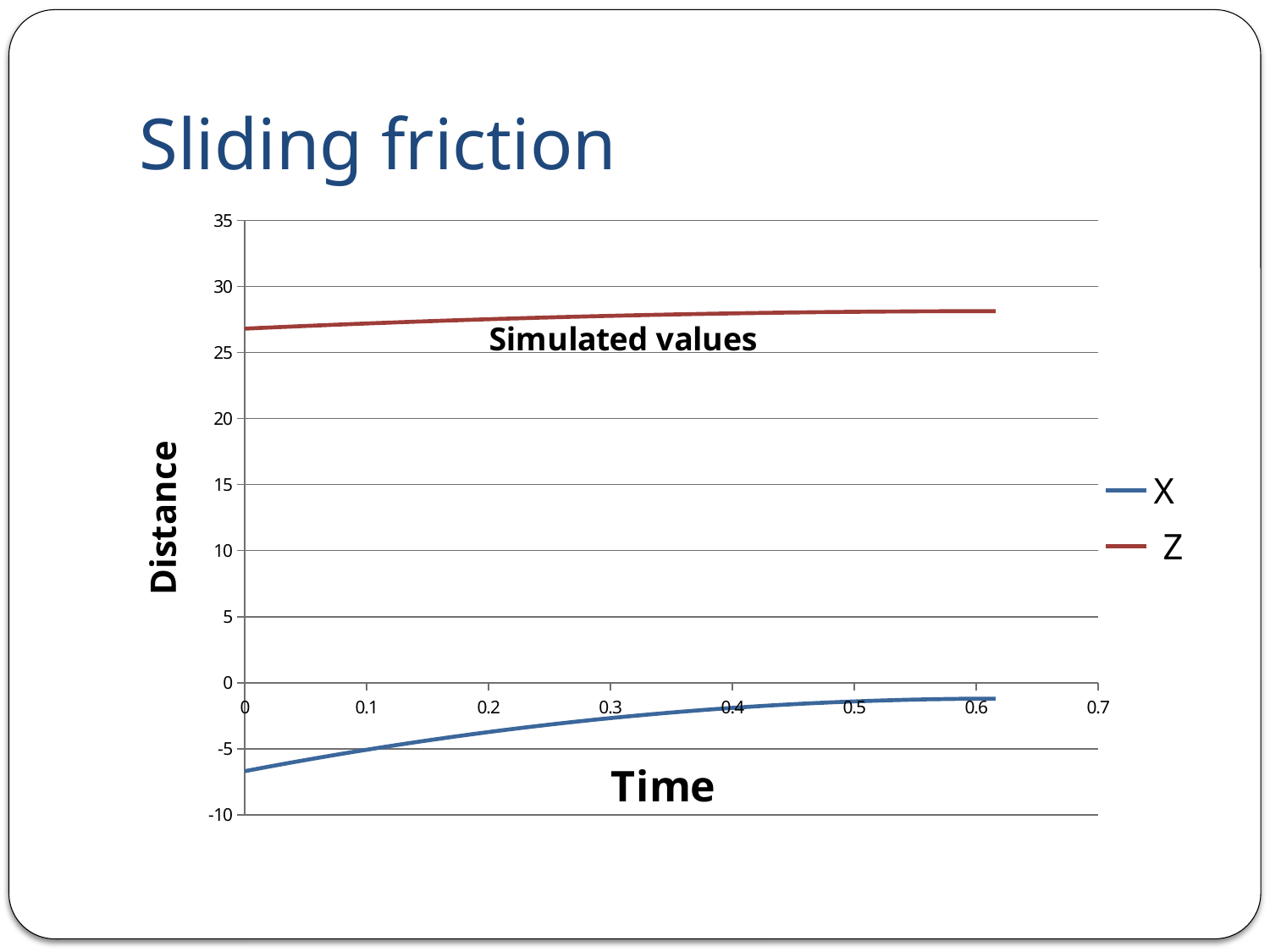
Does the X series rise or fall as time increases? rise How many series does the legend list? 2 What text annotation appears on the chart near the Z line? Simulated values Does the Z series rise or fall as time increases? rise Is the value of the Z series at time 0 greater or less than 25? greater Which series is plotted higher on the chart, X or Z? Z Is the value of the X series at time 0.3 greater or less than -5? greater What is the label of the vertical axis? Distance Is the value of the X series at time 0 greater or less than -5? less What kind of chart is shown on the slide? line chart